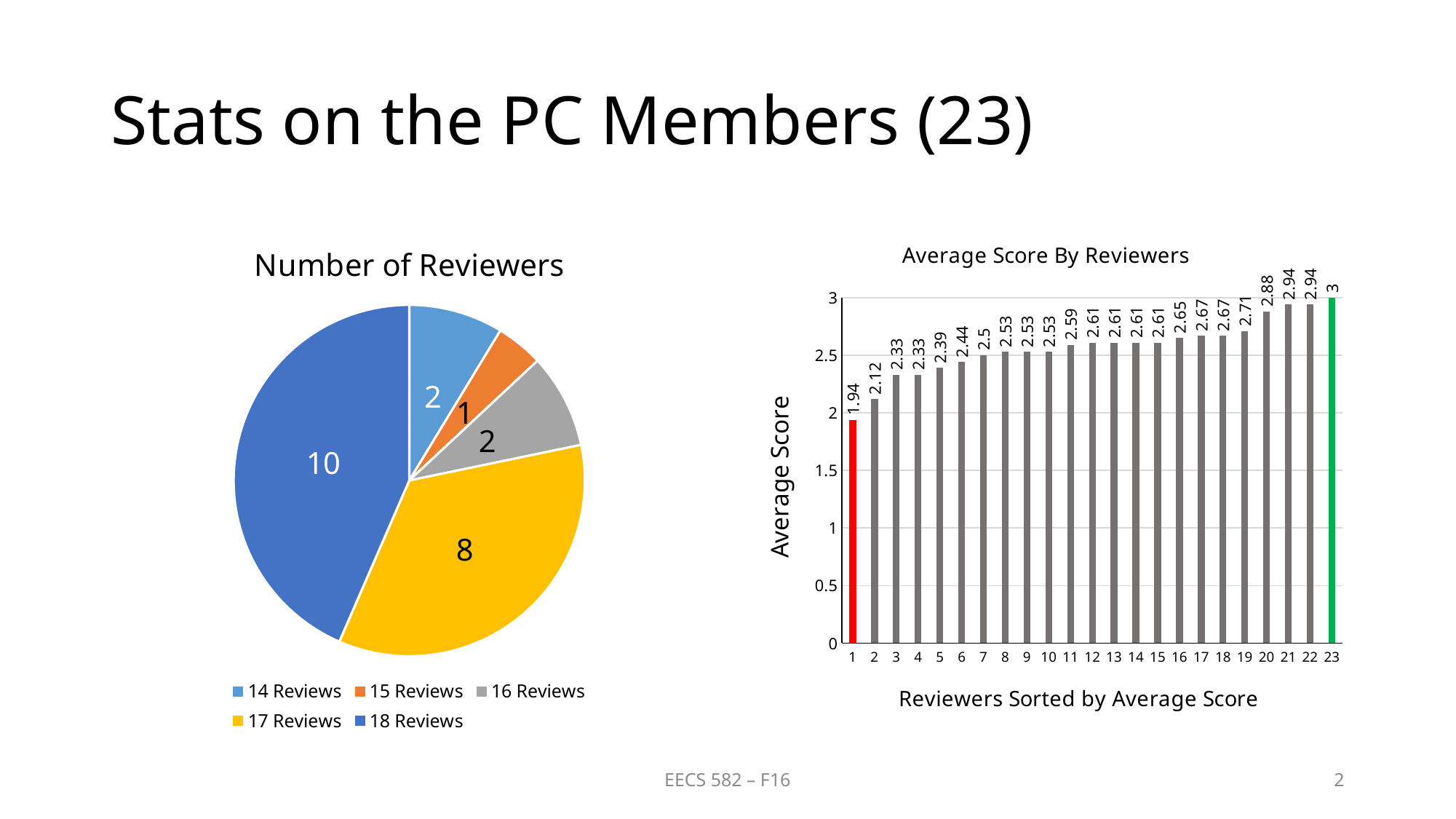
In the 'Number of Reviewers' pie chart, how many categories does the legend list? 5 In the 'Average Score By Reviewers' chart, how many reviewers are plotted on the x axis? 23 In the 'Number of Reviewers' pie chart, which category has the largest slice? 18 Reviews In the 'Average Score By Reviewers' chart, what is the average score of reviewer 23? 3 In the 'Number of Reviewers' pie chart, how many reviewers did 17 reviews? 8 In the 'Number of Reviewers' pie chart, what is the total of all slices? 23 In the 'Average Score By Reviewers' chart, do the values rise or fall from reviewer 1 to reviewer 23? rise In the 'Number of Reviewers' pie chart, which category has the smallest slice? 15 Reviews In the 'Number of Reviewers' pie chart, how many reviewers did 18 reviews? 10 In the 'Average Score By Reviewers' chart, what is the difference between the average scores of reviewer 23 and reviewer 1? 1.06 What kind of chart is 'Average Score By Reviewers'? bar chart In the 'Average Score By Reviewers' chart, what is the average score of reviewer 1? 1.94